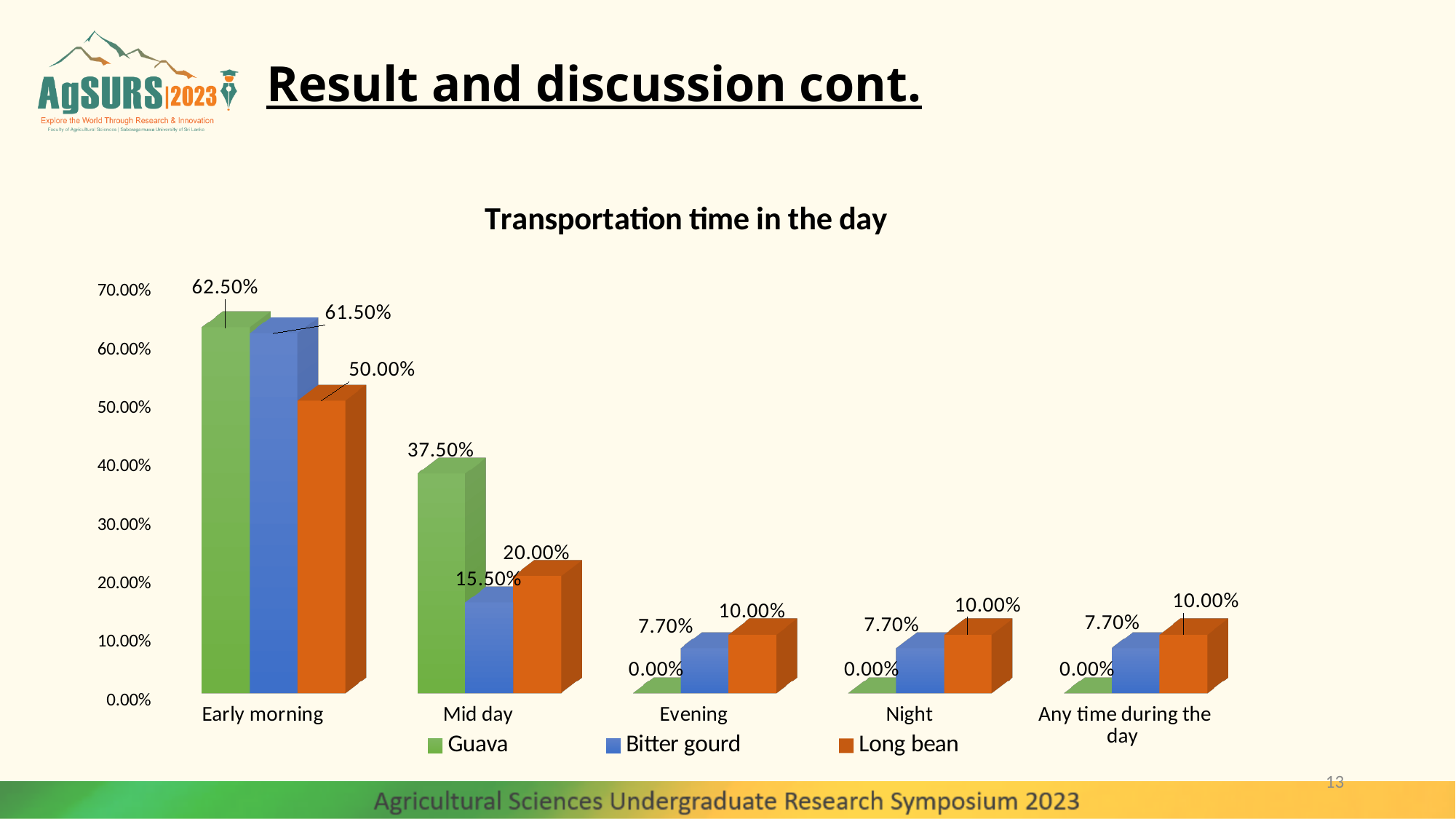
Which category has the highest value for Long bean? Early morning What is the value for Guava at Night? 0.00% How many series does the legend list? 3 What is the value for Guava at Early morning? 62.50% Which category has the lowest value for Guava? Evening, Night and Any time during the day (all 0.00%) What is the value for Long bean at Evening? 10.00% What is the title of the chart? Transportation time in the day What is the value for Bitter gourd at Mid day? 15.50% How many categories are shown on the x axis? 5 What is the difference between the Guava and Bitter gourd values at Mid day? 22.00% At Mid day, which is larger: the Bitter gourd value or the Long bean value? Long bean What kind of chart is shown on the slide? Bar chart